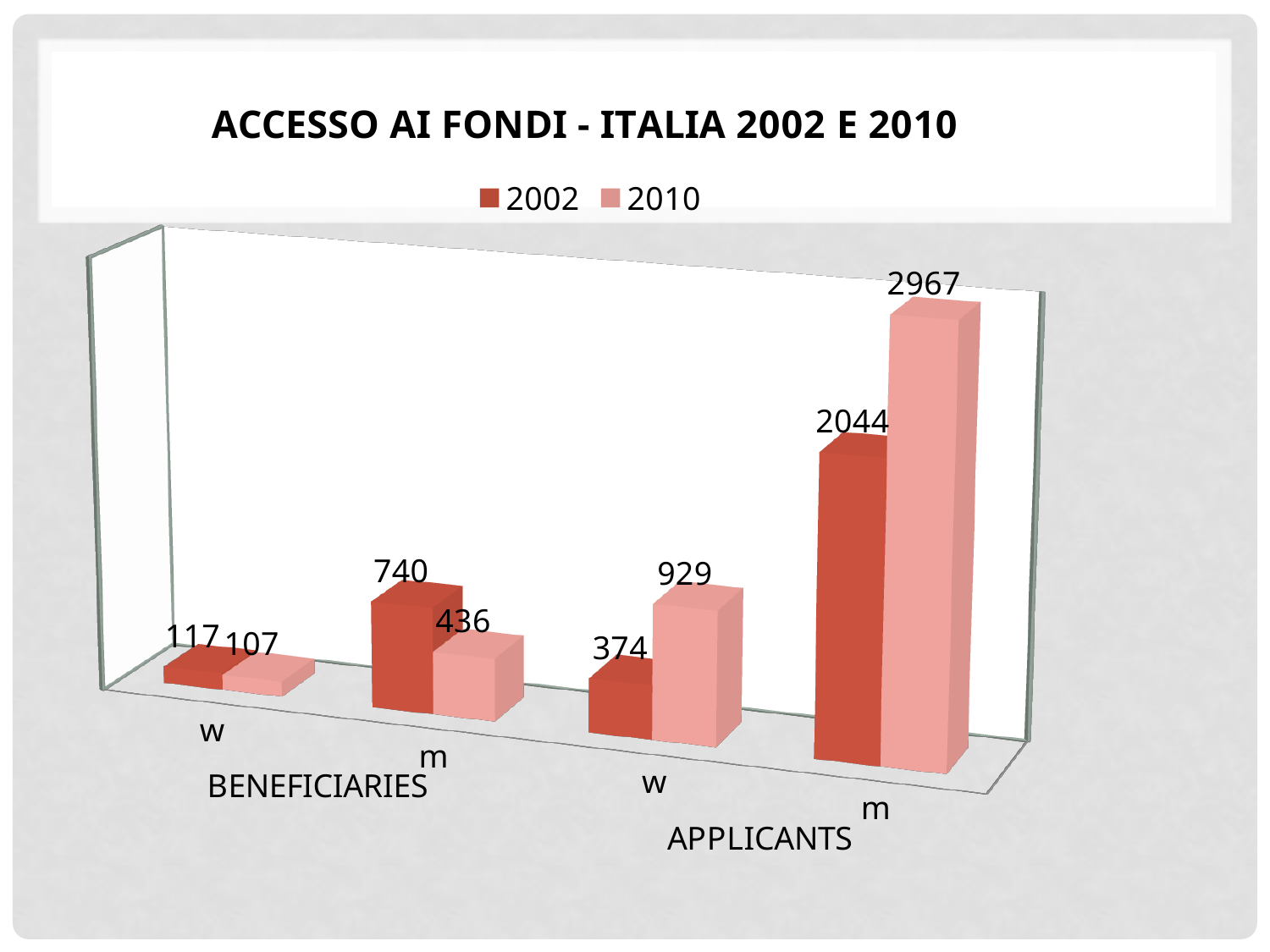
What kind of chart is shown on the slide? Bar chart What is the difference between the 2002 and 2010 values for m under BENEFICIARIES? 304 What is the 2002 value for w under BENEFICIARIES? 117 Which is larger for w under APPLICANTS, the 2002 value or the 2010 value? 2010 How many categories are shown on the x axis? 4 Which category has the highest 2010 value? m under APPLICANTS What is the 2010 value for m under APPLICANTS? 2967 Which category has the lowest 2002 value? w under BENEFICIARIES What is the difference between the 2010 and 2002 values for m under APPLICANTS? 923 How many series does the legend list? 2 What is the 2010 value for w under APPLICANTS? 929 What is the 2002 value for m under BENEFICIARIES? 740